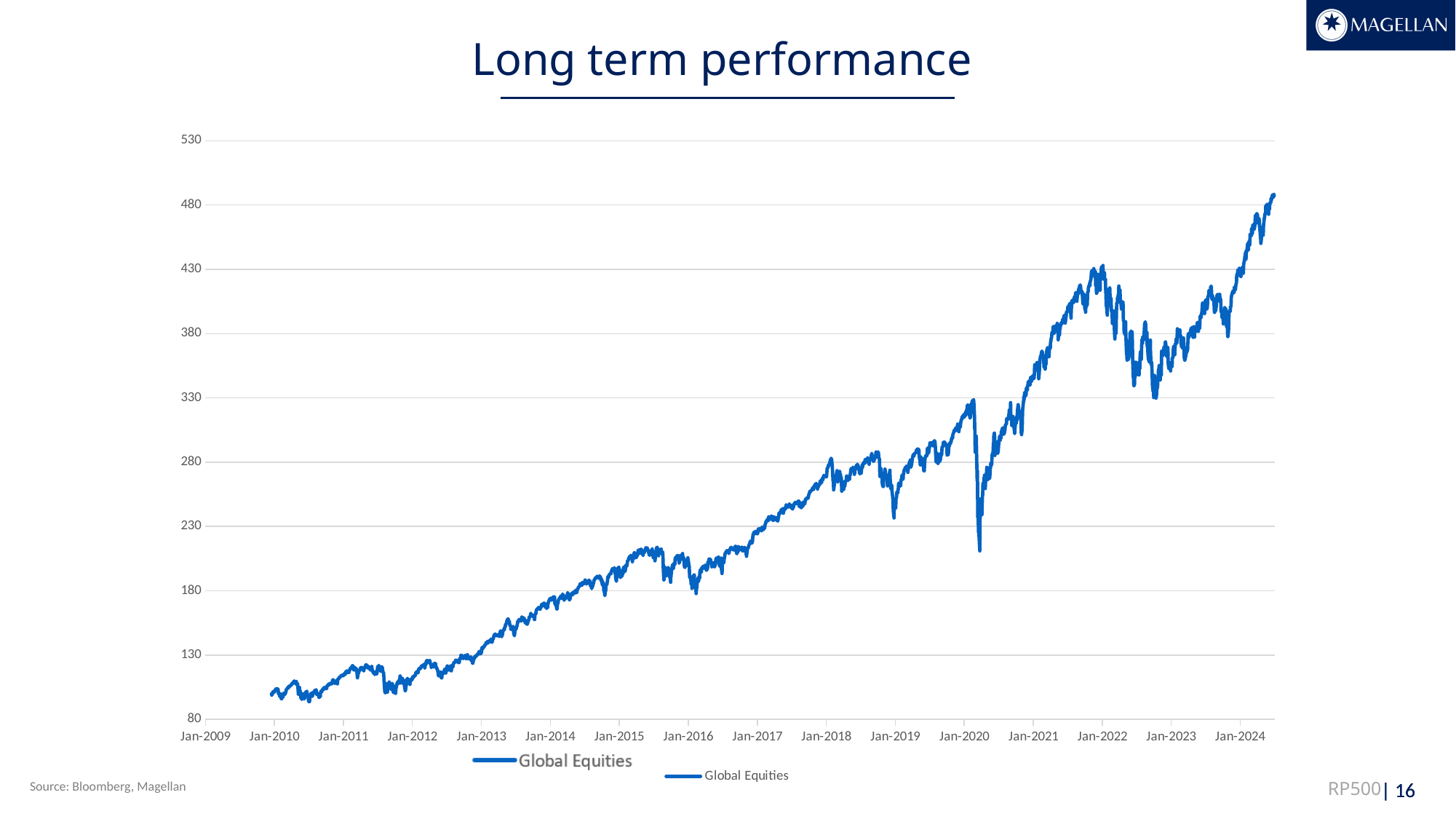
Which is larger, the value of Global Equities at Jan-2012 or at Jan-2021? Jan-2021 Is the value of Global Equities at Jan-2024 greater or less than 330? greater Is the value of Global Equities at Jan-2022 greater or less than 380? greater Is the value of Global Equities at Jan-2020 greater or less than 280? greater What kind of chart is shown on the slide? Line chart Overall, does the Global Equities line rise or fall from Jan-2010 to the end of the chart? Rise What series name does the chart legend show? Global Equities What is the title of the chart on the slide? Long term performance